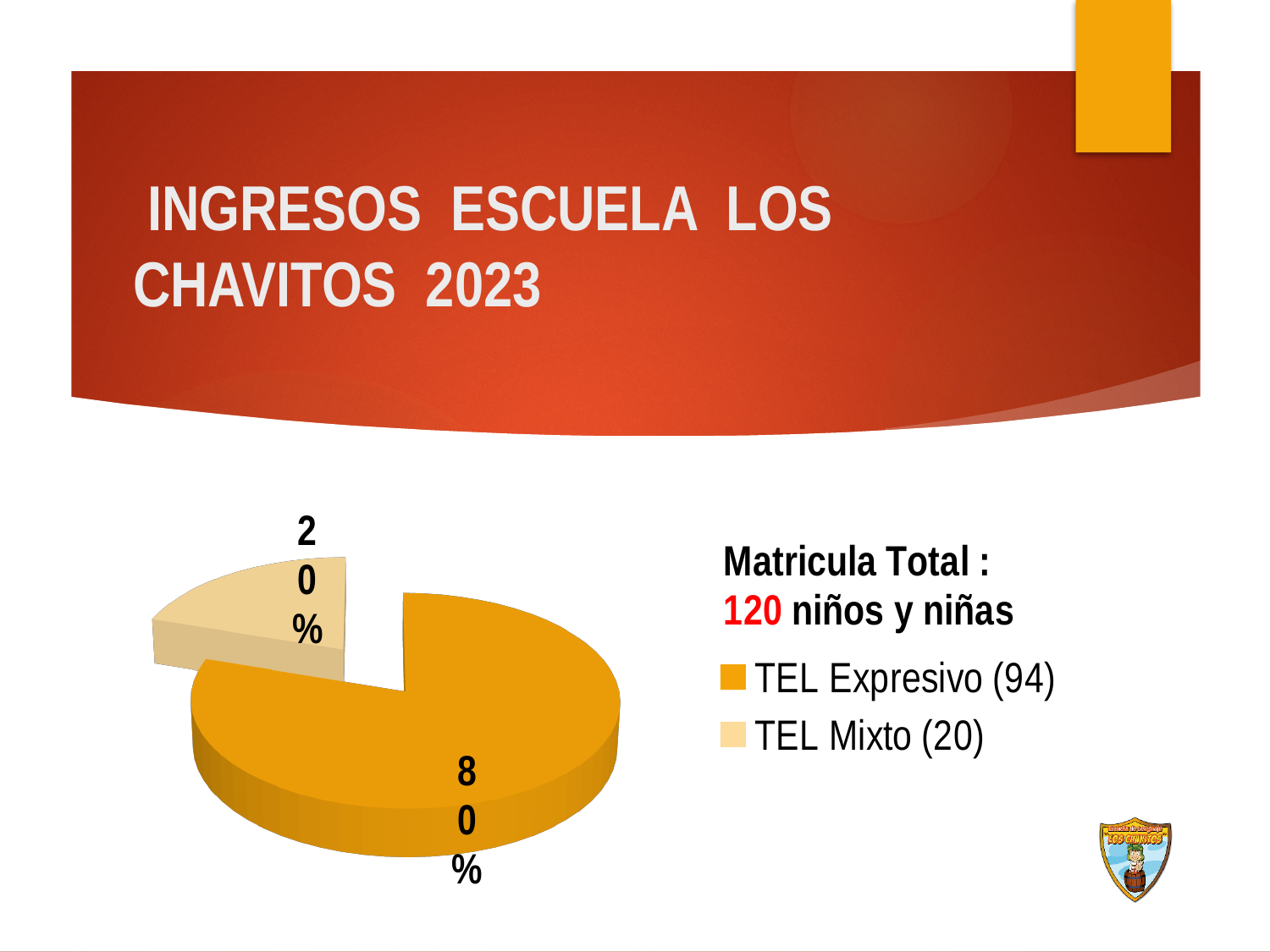
How many slices does the pie chart have? 2 Which slice of the pie chart is the largest? TEL Expresivo (94) What is the title shown at the top of the slide? INGRESOS ESCUELA LOS CHAVITOS 2023 What colour is the TEL Expresivo slice in the pie chart? Orange What kind of chart is shown on the slide? Pie chart Which is larger, the TEL Expresivo slice or the TEL Mixto slice? TEL Expresivo Which slice of the pie chart is the smallest? TEL Mixto (20) What share of the pie does the TEL Mixto slice represent? 20% How many entries does the legend of the pie chart list? 2 What percentage is shown for the TEL Mixto slice? 20% What is the difference in percentage points between the TEL Expresivo slice and the TEL Mixto slice? 60 What percentage is shown for the TEL Expresivo slice? 80%